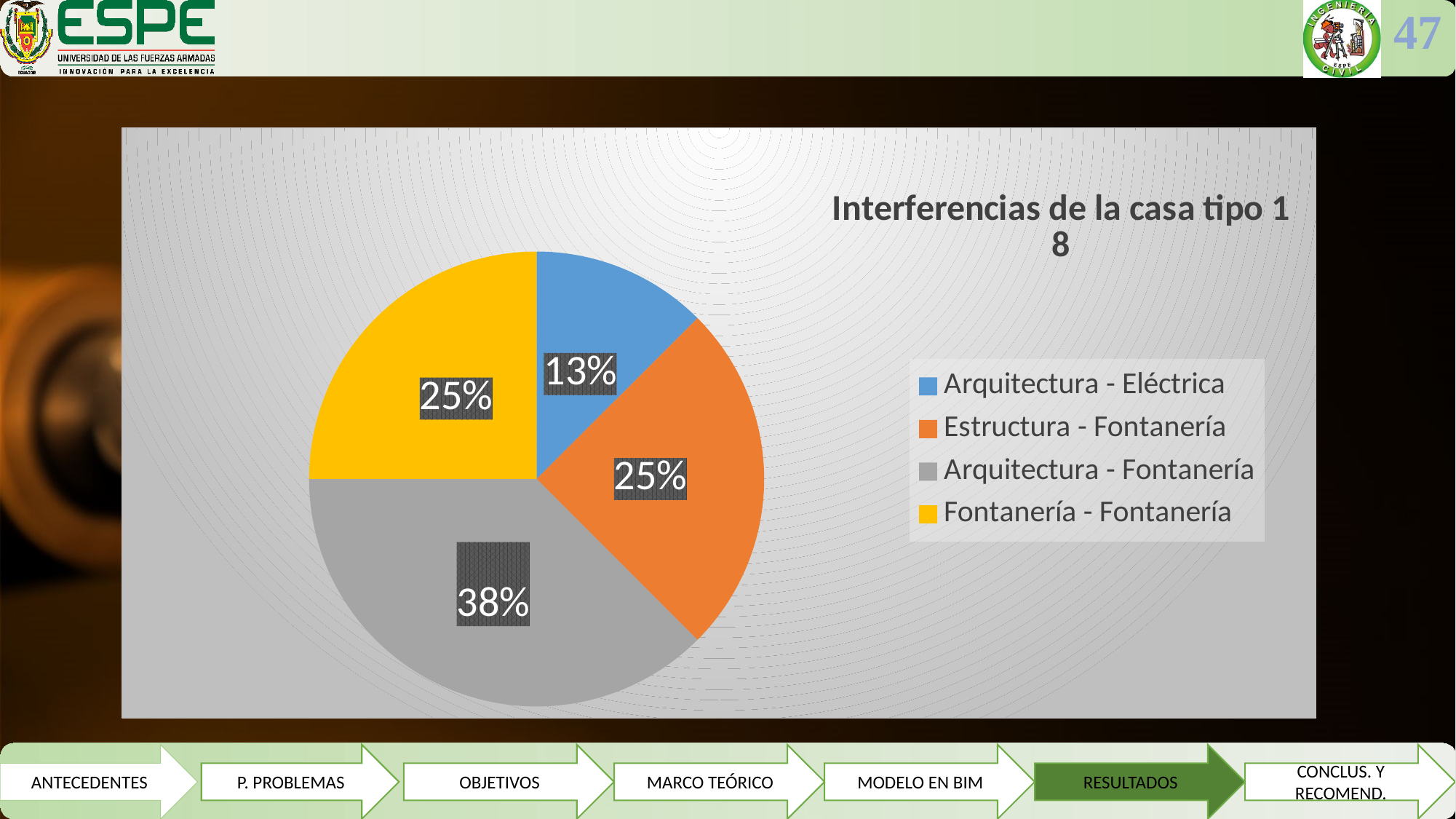
How many slices does the pie chart have? 4 Which category has the smallest slice of the pie? Arquitectura - Eléctrica Which slice is larger: Arquitectura - Fontanería or Arquitectura - Eléctrica? Arquitectura - Fontanería What colour is the slice for Fontanería - Fontanería? yellow What percentage of the pie is labelled for Arquitectura - Fontanería? 38% What percentage of the pie is labelled for Estructura - Fontanería? 25% Which category has the largest slice of the pie? Arquitectura - Fontanería How many entries does the legend list? 4 What type of chart is shown on the slide? pie chart What percentage of the pie is labelled for Arquitectura - Eléctrica? 13% What percentage of the pie is labelled for Fontanería - Fontanería? 25% What is the difference in percentage points between the Arquitectura - Fontanería slice and the Arquitectura - Eléctrica slice? 25 percentage points